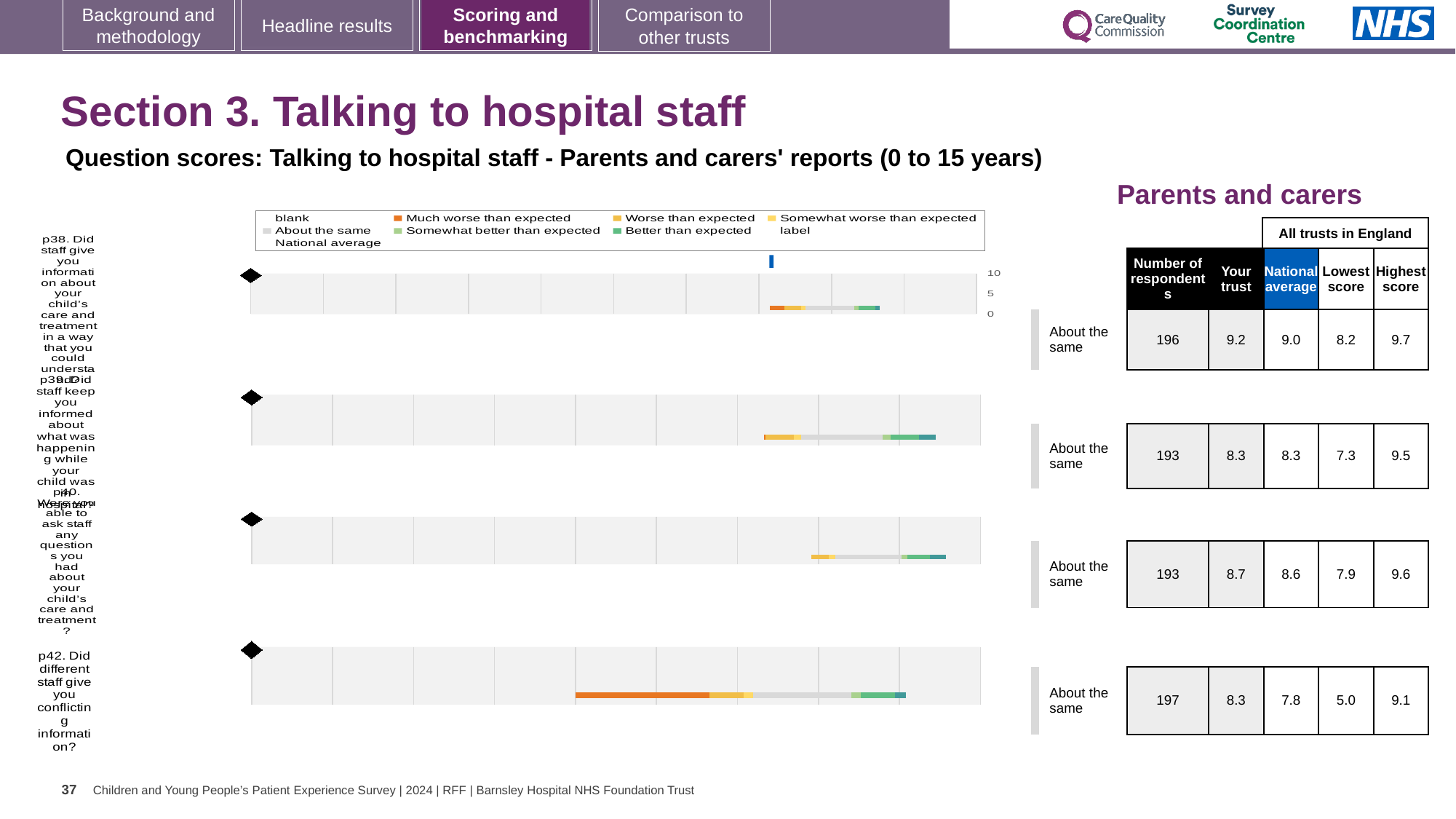
For question p38 (Did staff give you information about your child's care and treatment in a way that you could understand?), what is the 'Your trust' score? 9.2 For question p42, what is the difference between the 'Your trust' score and the national average? 0.5 For question p40 (Were you able to ask staff any questions you had about your child's care and treatment?), which is larger: the 'Your trust' score or the national average? Your trust For question p39 (Did staff keep you informed about what was happening while your child was in hospital?), how many respondents were there? 193 Which question has the highest 'Your trust' score? p38 How many survey questions (p38, p39, p40, p42) are plotted on the slide? 4 For question p42 (Did different staff give you conflicting information?), what is the national average score? 7.8 What kind of chart is used to show the question scores on this slide? bar chart Which question has the highest number of respondents? p42 What benchmark category is shown next to the chart for question p39? About the same Which question has the lowest 'Lowest score' across all trusts in England? p42 What is the heading above the table of scores on the right of the slide? Parents and carers